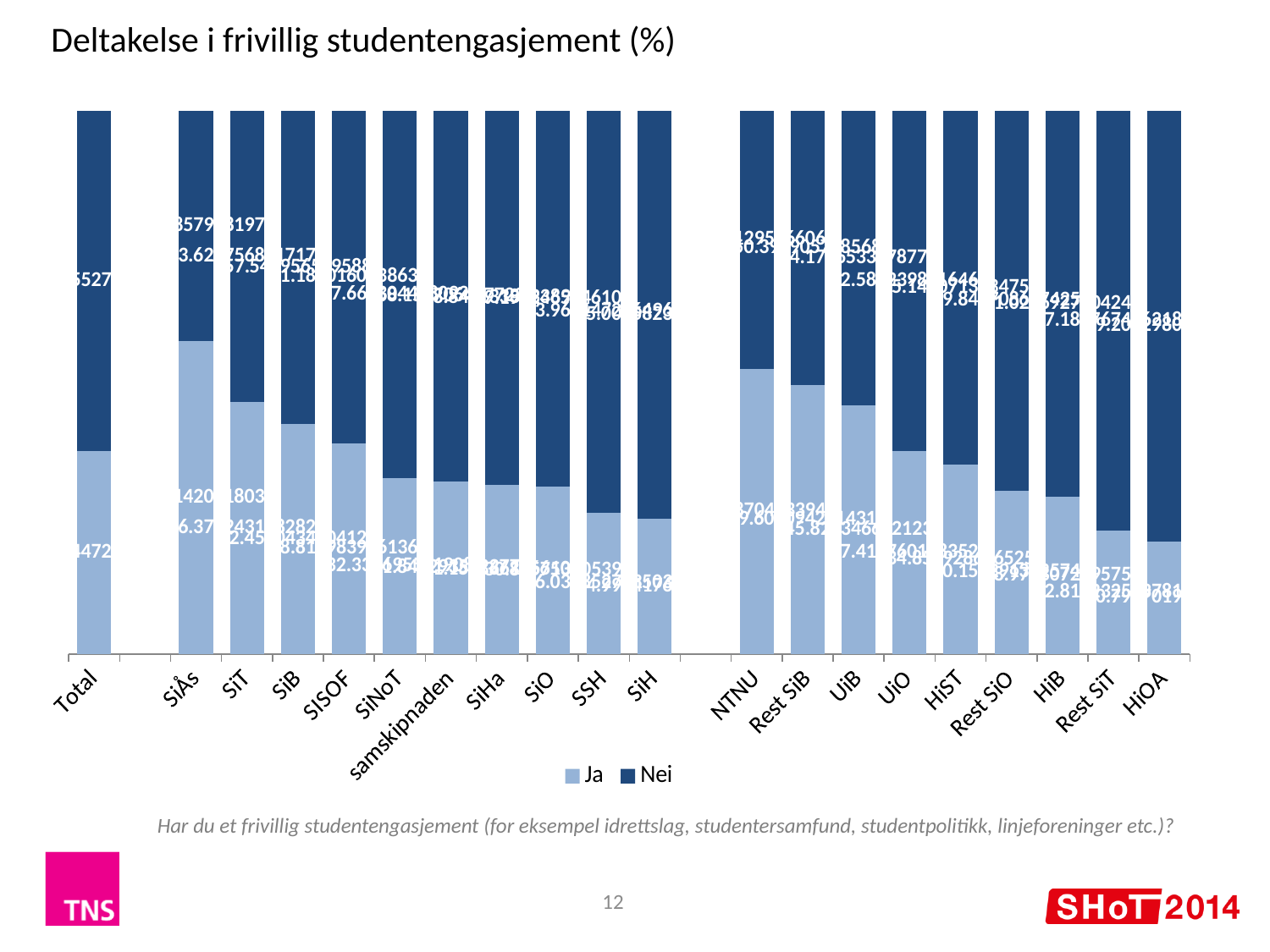
How many categories are shown along the x axis? 20 Which category has the largest Ja share? SiÅs Which has a larger Ja share, UiB or UiO? UiB What are the two series named in the legend? Ja and Nei How many series does the legend list? 2 Which has a larger Ja share, Total or SiÅs? SiÅs What kind of chart is shown on the slide? Stacked bar chart Which has a larger Ja share, NTNU or HiOA? NTNU What is the title of the chart? Deltakelse i frivillig studentengasjement (%)